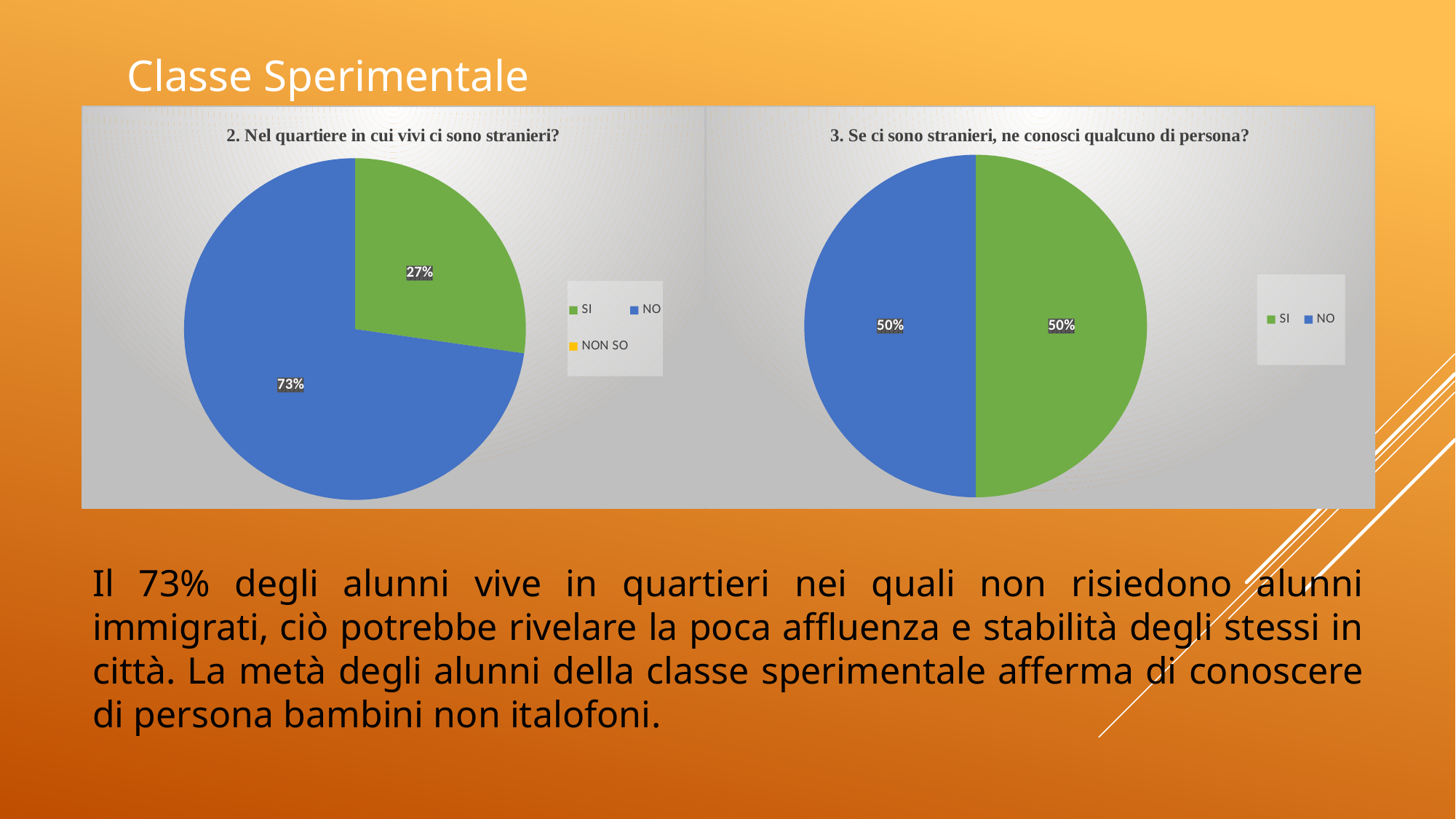
In the left chart titled "2. Nel quartiere in cui vivi ci sono stranieri?", what is the difference between the NO and SI percentages? 46% In the left chart titled "2. Nel quartiere in cui vivi ci sono stranieri?", what percentage is shown for NO? 73% In the left chart titled "2. Nel quartiere in cui vivi ci sono stranieri?", what percentage is shown for SI? 27% In the left chart titled "2. Nel quartiere in cui vivi ci sono stranieri?", which legend entry has no visible slice in the pie? NON SO In the right chart titled "3. Se ci sono stranieri, ne conosci qualcuno di persona?", what percentage is shown for SI? 50% In the right chart titled "3. Se ci sono stranieri, ne conosci qualcuno di persona?", what percentage is shown for NO? 50% How many pie charts are shown on the slide? 2 In the left chart titled "2. Nel quartiere in cui vivi ci sono stranieri?", how many entries does the legend list? 3 In the right chart titled "3. Se ci sono stranieri, ne conosci qualcuno di persona?", what colour is the SI slice? Green In the right chart titled "3. Se ci sono stranieri, ne conosci qualcuno di persona?", how many entries does the legend list? 2 What type of chart is the right chart titled "3. Se ci sono stranieri, ne conosci qualcuno di persona?"? Pie chart In the left chart titled "2. Nel quartiere in cui vivi ci sono stranieri?", which category has the largest slice? NO